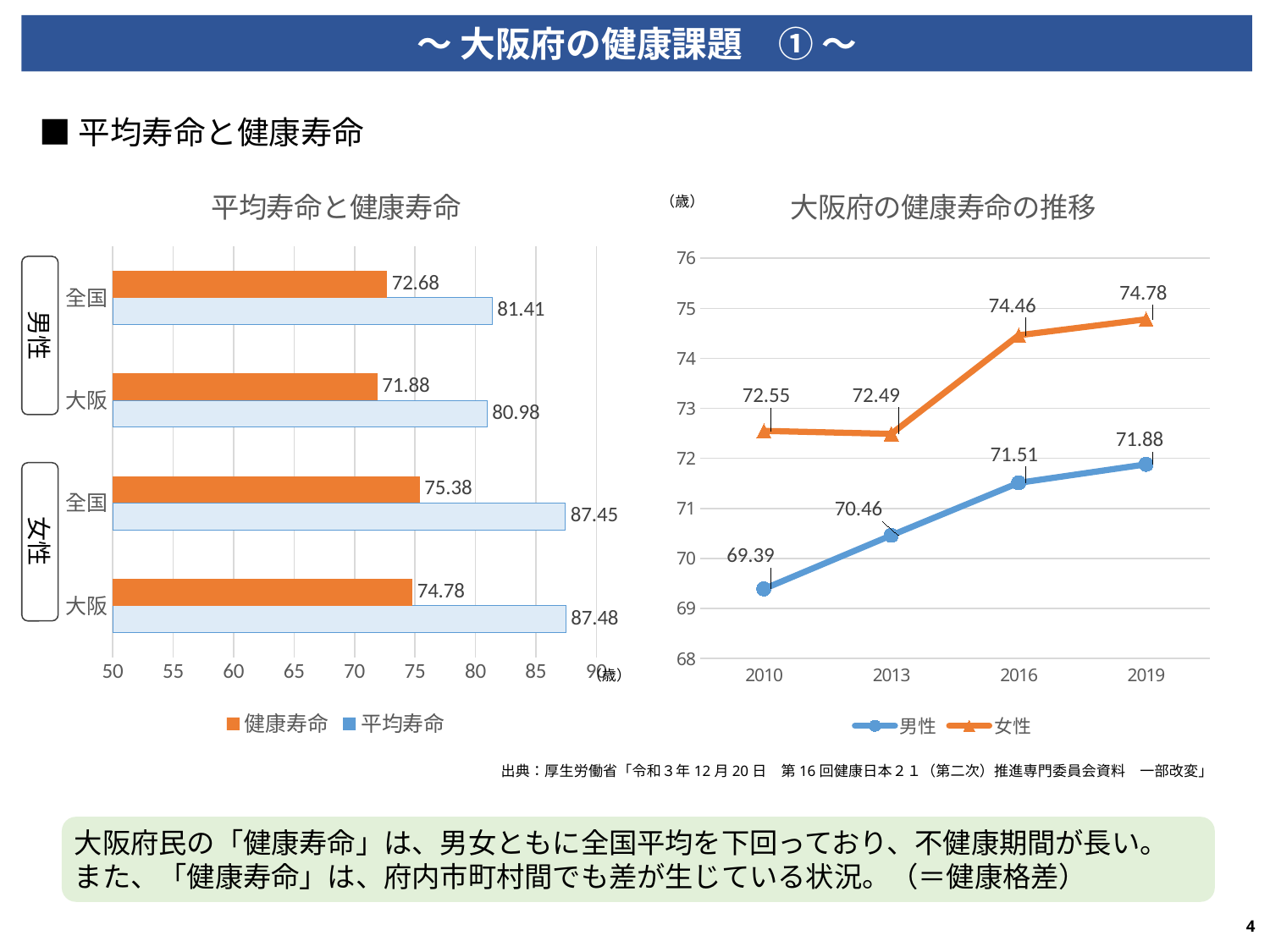
In the chart titled 大阪府の健康寿命の推移, what is the difference between the 女性 and 男性 values in 2019? 2.90 In the chart titled 平均寿命と健康寿命, what is the 平均寿命 value for 女性 全国? 87.45 In the chart titled 大阪府の健康寿命の推移, what is the 男性 value for 2010? 69.39 In the chart titled 平均寿命と健康寿命, how many series does the legend list? 2 In the chart titled 平均寿命と健康寿命, what is the difference between the 平均寿命 and 健康寿命 values for 男性 全国? 8.73 In the chart titled 大阪府の健康寿命の推移, in which year is the 男性 value lowest? 2010 In the chart titled 平均寿命と健康寿命, which is larger, the 健康寿命 for 女性 全国 or for 女性 大阪? 女性 全国 In the chart titled 大阪府の健康寿命の推移, how many years are plotted on the x axis? 4 In the chart titled 平均寿命と健康寿命, what is the 健康寿命 value for 男性 大阪? 71.88 What kind of chart is the chart titled 平均寿命と健康寿命? bar chart In the chart titled 大阪府の健康寿命の推移, does the 男性 series rise or fall from 2010 to 2019? rise In the chart titled 大阪府の健康寿命の推移, what is the 女性 value for 2016? 74.46